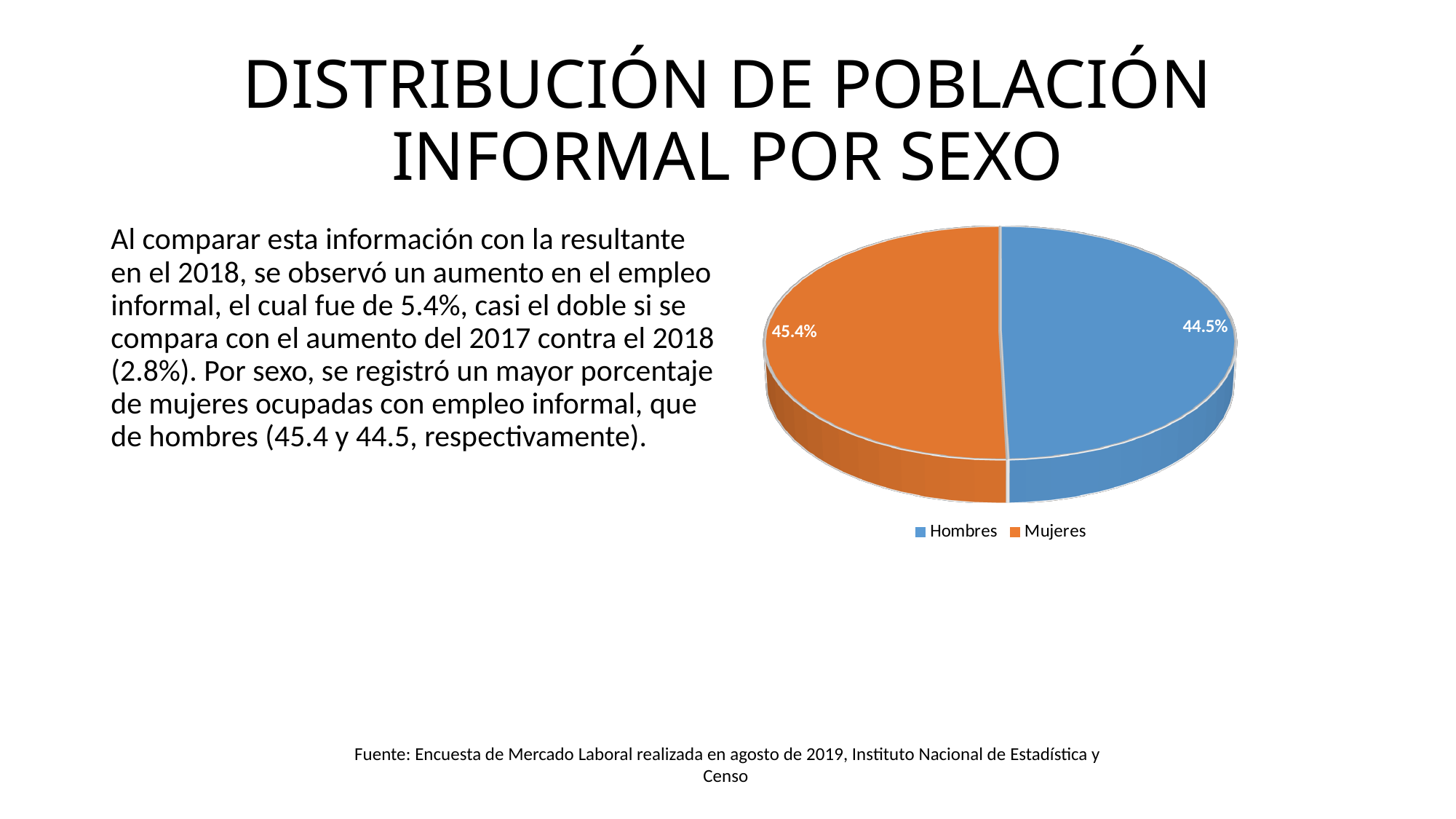
How many entries does the legend of the pie chart list? 2 Which slice of the pie chart has the larger value, Hombres or Mujeres? Mujeres What is the value shown for Hombres in the pie chart? 44.5% What is the value shown for Mujeres in the pie chart? 45.4% What kind of chart is shown on the slide? pie chart Which category has the highest value in the pie chart? Mujeres Which category has the lowest value in the pie chart? Hombres What share of the pie is labelled for Hombres? 44.5% What colour is the Hombres slice in the pie chart? blue How many slices does the pie chart have? 2 What colour is the Mujeres slice in the pie chart? orange What is the difference between the values for Mujeres and Hombres in the pie chart? 0.9%